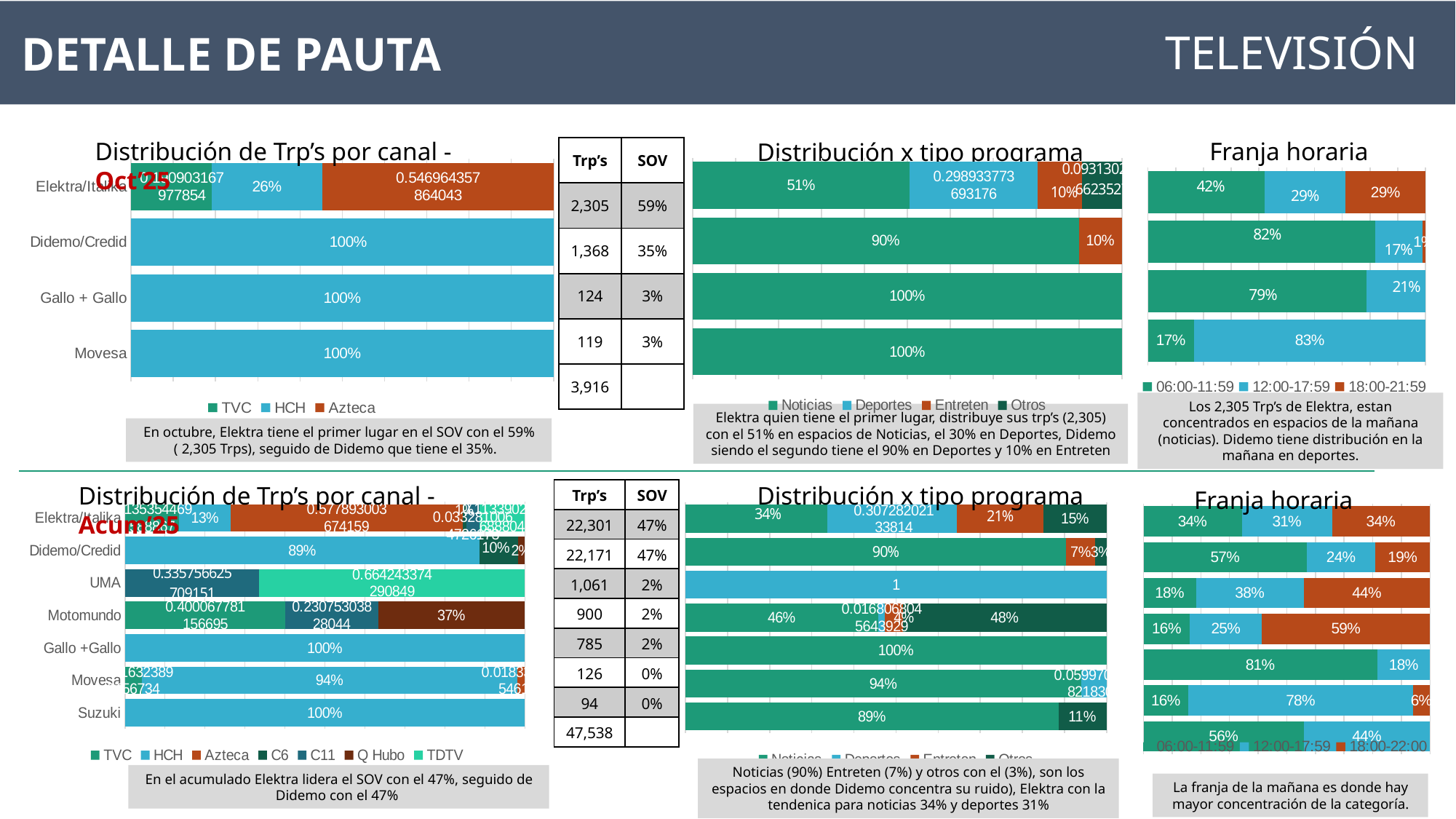
In the top-left chart 'Distribución de Trp's por canal - Oct'25', what kind of chart is shown? Stacked bar chart In the bottom-right chart 'Franja horaria', which category has the highest 18:00-22:00 share? Motomundo In the bottom-left chart 'Distribución de Trp's por canal - Acum'25', how many categories are shown? 7 In the top-left chart 'Distribución de Trp's por canal - Oct'25', how many series does the legend list? 3 In the bottom-left chart 'Distribución de Trp's por canal - Acum'25', what is the HCH share for Didemo/Credid? 89% In the top-right chart 'Franja horaria', what is the difference between the 06:00-11:59 share for Didemo/Credid and for Gallo + Gallo? 3% In the top-middle chart 'Distribución x tipo programa', what is the Noticias share for Elektra/Italika? 51% In the top-middle chart 'Distribución x tipo programa', what is the Noticias share for Didemo/Credid? 90% In the bottom-left chart 'Distribución de Trp's por canal - Acum'25', what is the Q Hubo share for Motomundo? 37% In the bottom-middle chart 'Distribución x tipo programa', what is the Otros share for Motomundo? 48% In the top-right chart 'Franja horaria', what is the 12:00-17:59 share for Movesa? 83% In the top-left chart 'Distribución de Trp's por canal - Oct'25', what is the HCH share for Elektra/Italika? 26%